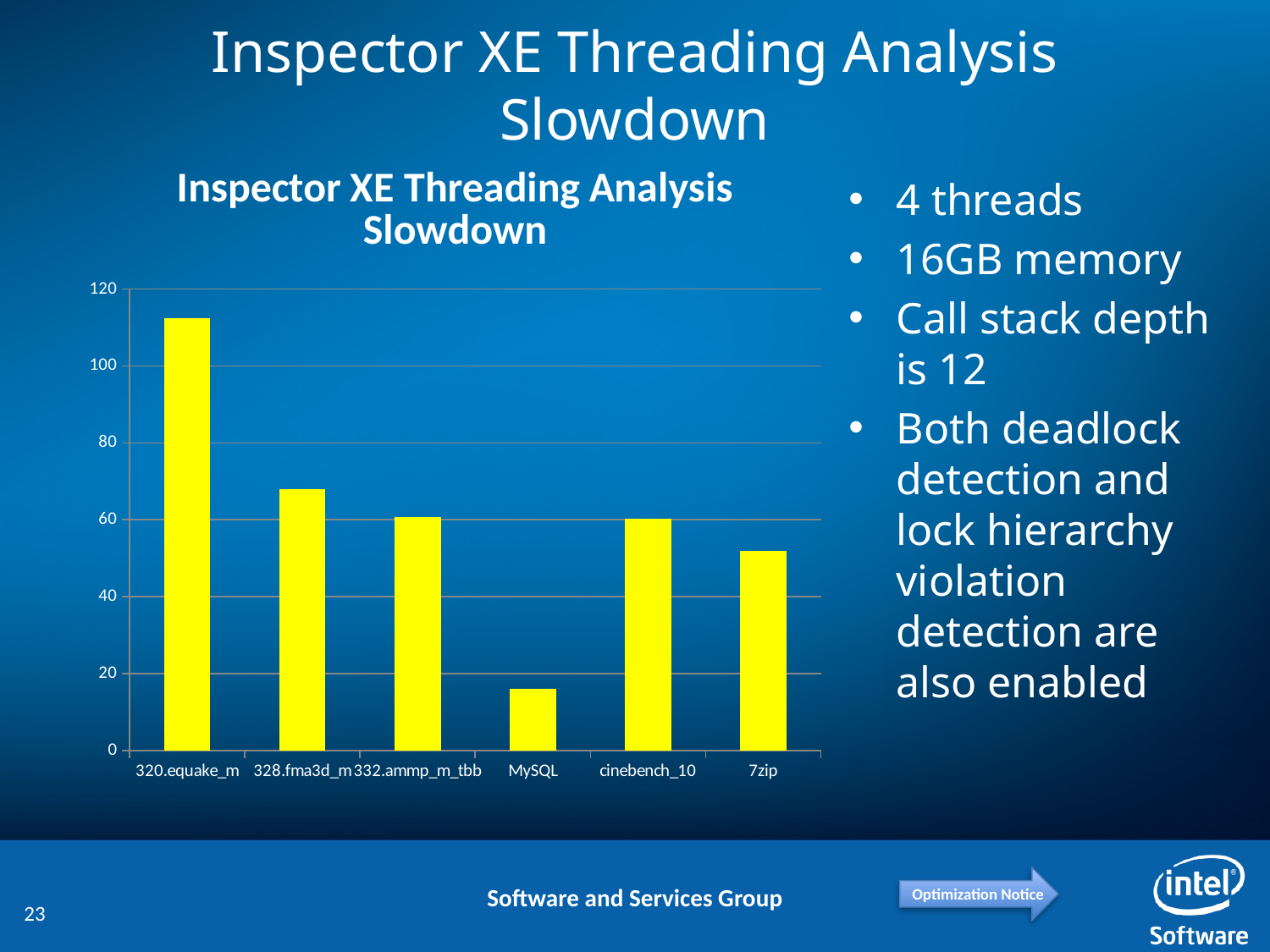
What colour are the bars in the chart? yellow What kind of chart is shown on the slide? bar chart Is the value for cinebench_10 greater or less than 40? greater Which has a larger value, 320.equake_m or 7zip? 320.equake_m What is the title of the chart? Inspector XE Threading Analysis Slowdown Is the value for MySQL greater or less than 20? less Is the value for 320.equake_m greater or less than 100? greater How many categories are plotted on the x axis of the chart? 6 Which category has the highest slowdown in the chart? 320.equake_m Which category has the lowest slowdown in the chart? MySQL